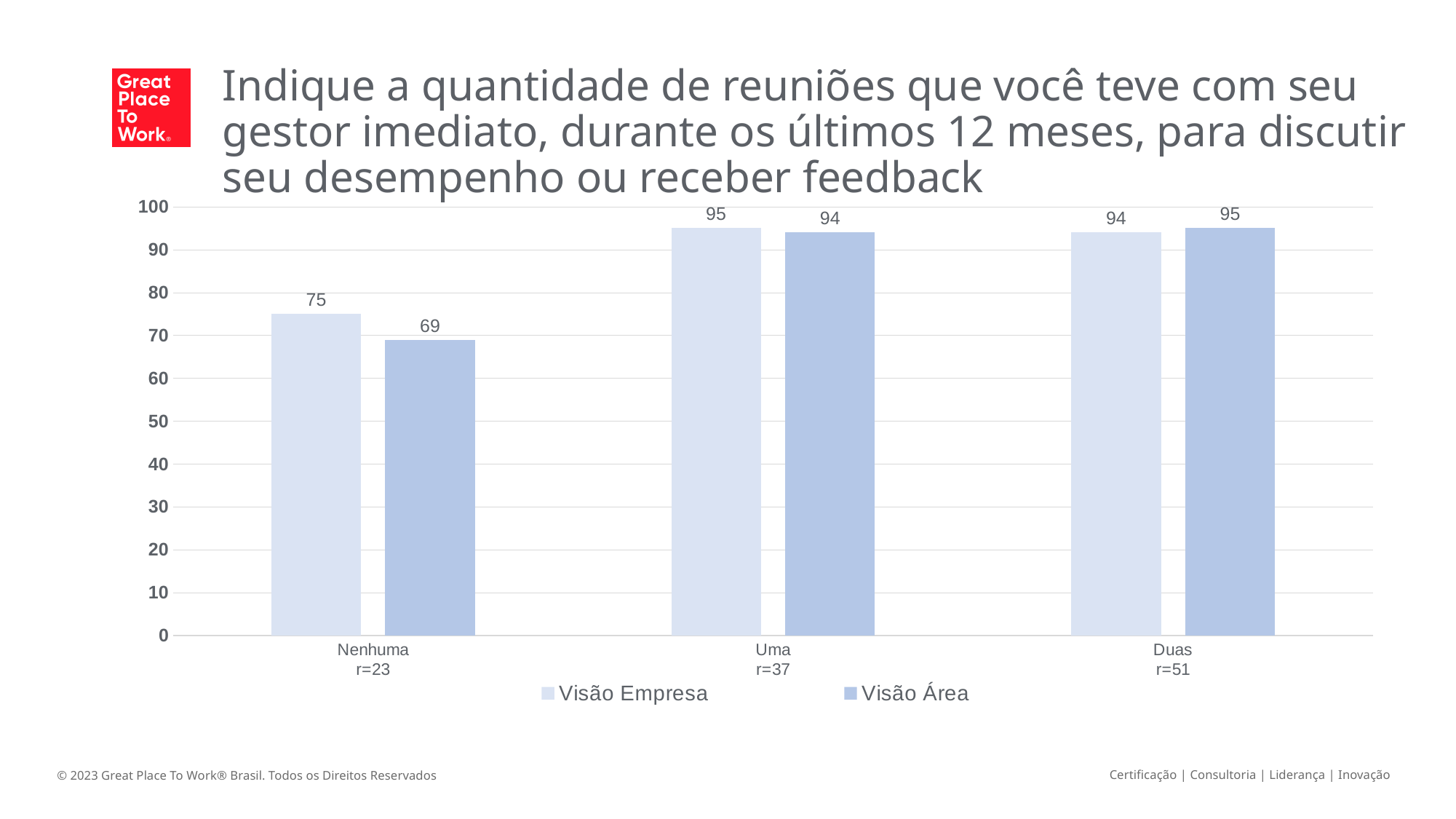
Which category has the lowest Visão Área value? Nenhuma What is the Visão Empresa value for Uma? 95 What is the difference between the Visão Empresa and Visão Área values for Nenhuma? 6 What is the Visão Empresa value for Nenhuma? 75 For Nenhuma, which is larger: Visão Empresa or Visão Área? Visão Empresa What is the difference between the Visão Empresa values for Uma and Nenhuma? 20 Is the Visão Área value for Nenhuma greater or less than 80? less How many series does the legend list? 2 What is the Visão Área value for Nenhuma? 69 How many categories are shown on the x axis? 3 What is the Visão Área value for Duas? 95 What kind of chart is shown on the slide? bar chart